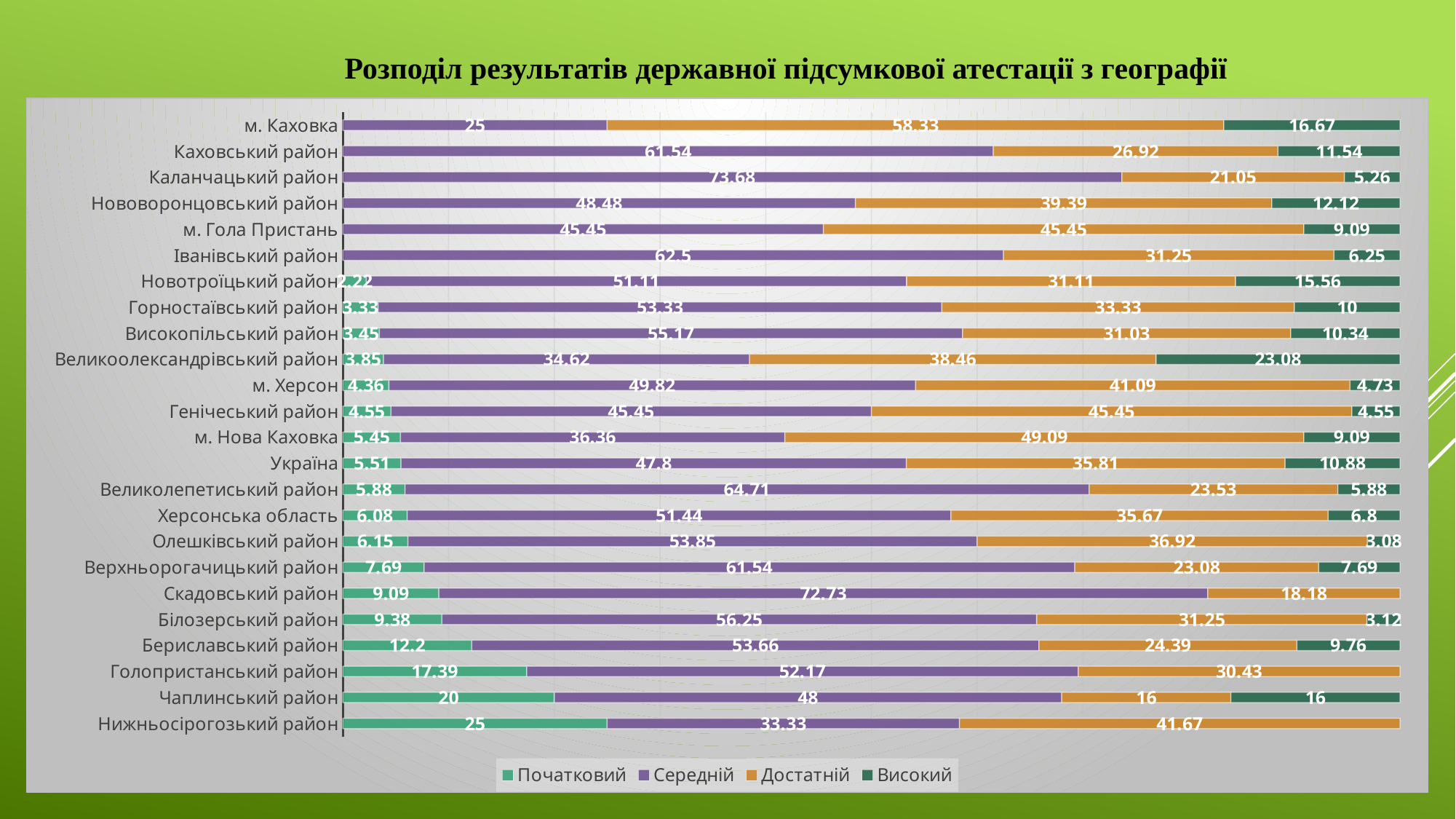
Which has a larger Достатній value, м. Каховка or Каховський район? м. Каховка What is the Середній value for Каланчацький район? 73.68 What is the difference between the Середній values for Херсонська область and Україна? 3.64 What is the total of the stacked bar for Чаплинський район? 100 What is the Достатній value for м. Нова Каховка? 49.09 What is the Початковий value for Голопристанський район? 17.39 How many series does the legend list? 4 Which category has the highest Середній value? Каланчацький район How many categories (regions) are plotted on the chart? 24 What kind of chart is shown on the slide? Stacked bar chart What is the Високий value for Великоолександрівський район? 23.08 Which category has the highest Достатній value? м. Каховка